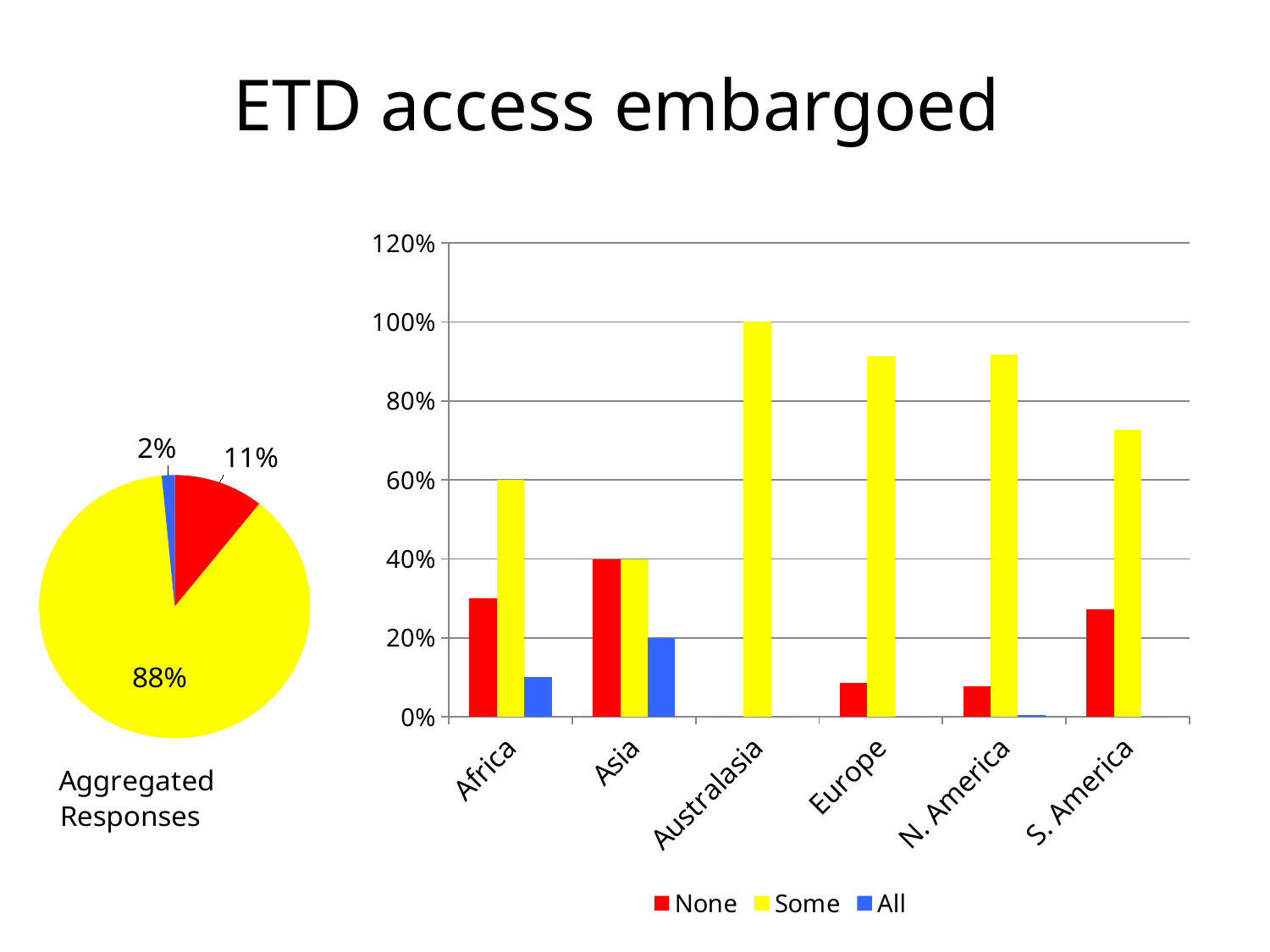
What kind of chart is the chart on the left of the slide? pie chart In the bar chart on the right, which is larger: the None bar for Asia or the None bar for Africa? Asia In the bar chart on the right, what is the value of the Some bar for Australasia? 100% What kind of chart is the chart on the right of the slide? bar chart In the bar chart on the right, which region has the highest Some bar? Australasia In the pie chart on the left, what share does the largest slice represent? 88% In the bar chart on the right, what is the value of the All bar for Asia? 20% In the bar chart on the right, how many regions are shown on the x axis? 6 In the bar chart on the right, what is the value of the Some bar for Africa? 60% In the bar chart on the right, how many series does the legend list? 3 In the bar chart on the right, is the Some value for S. America greater or less than 80%? less In the pie chart on the left, what share does the smallest slice represent? 2%